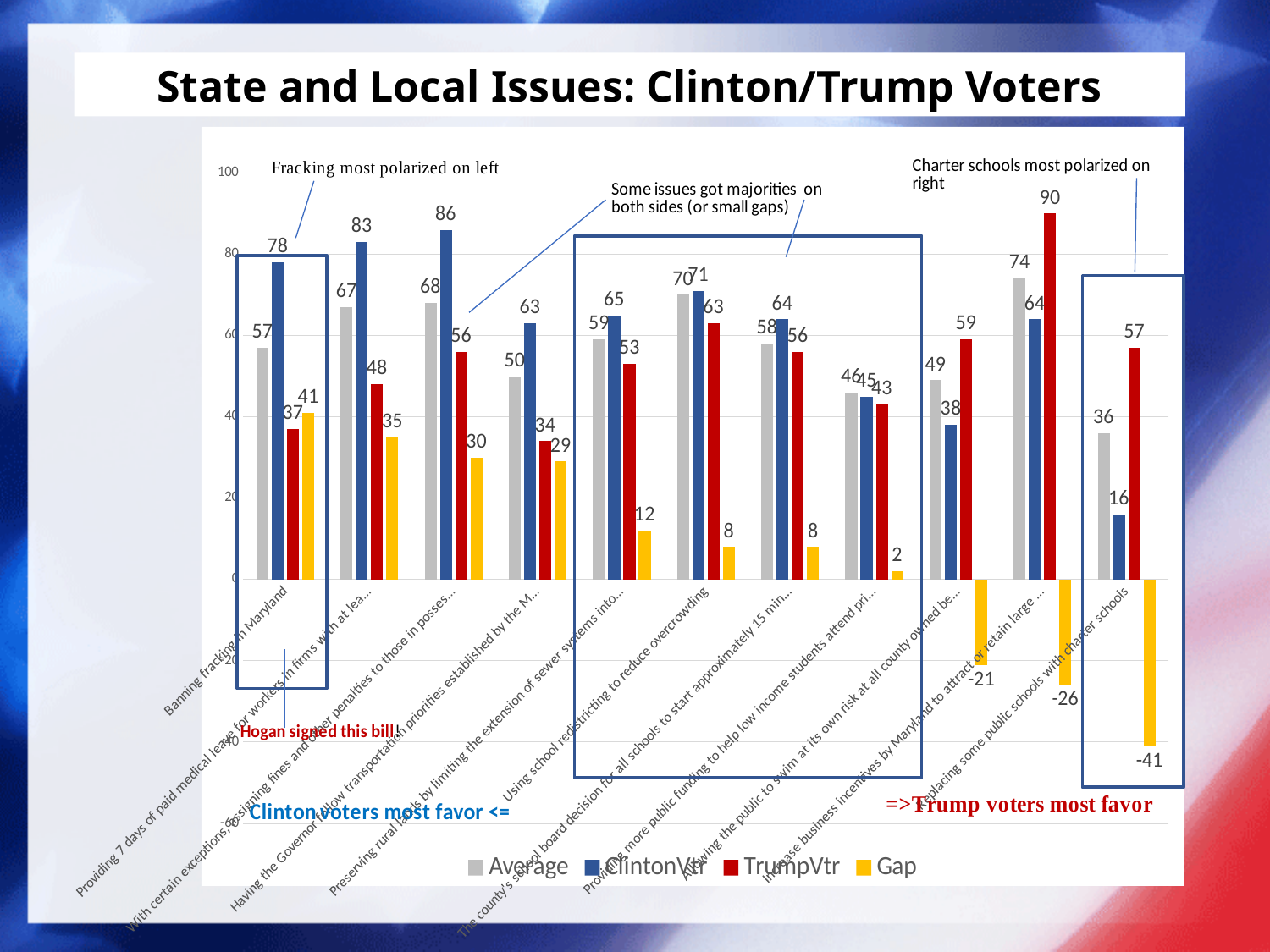
How many series does the legend list? 4 How many issue categories are plotted along the x axis? 11 Which category has the lowest ClintonVtr value? Replacing some public schools with charter schools What is the Gap value for 'Replacing some public schools with charter schools'? -41 What is the ClintonVtr value for 'Banning fracking in Maryland'? 78 What is the highest TrumpVtr value shown on the chart? 90 What is the difference between the ClintonVtr and TrumpVtr values for 'Banning fracking in Maryland'? 41 What is the TrumpVtr value for 'Replacing some public schools with charter schools'? 57 What are the four series listed in the legend? Average, ClintonVtr, TrumpVtr, Gap What is the Average value for 'Using school redistricting to reduce overcrowding'? 70 What kind of chart is shown on the slide? bar chart For 'Using school redistricting to reduce overcrowding', which is larger: the ClintonVtr value or the TrumpVtr value? ClintonVtr